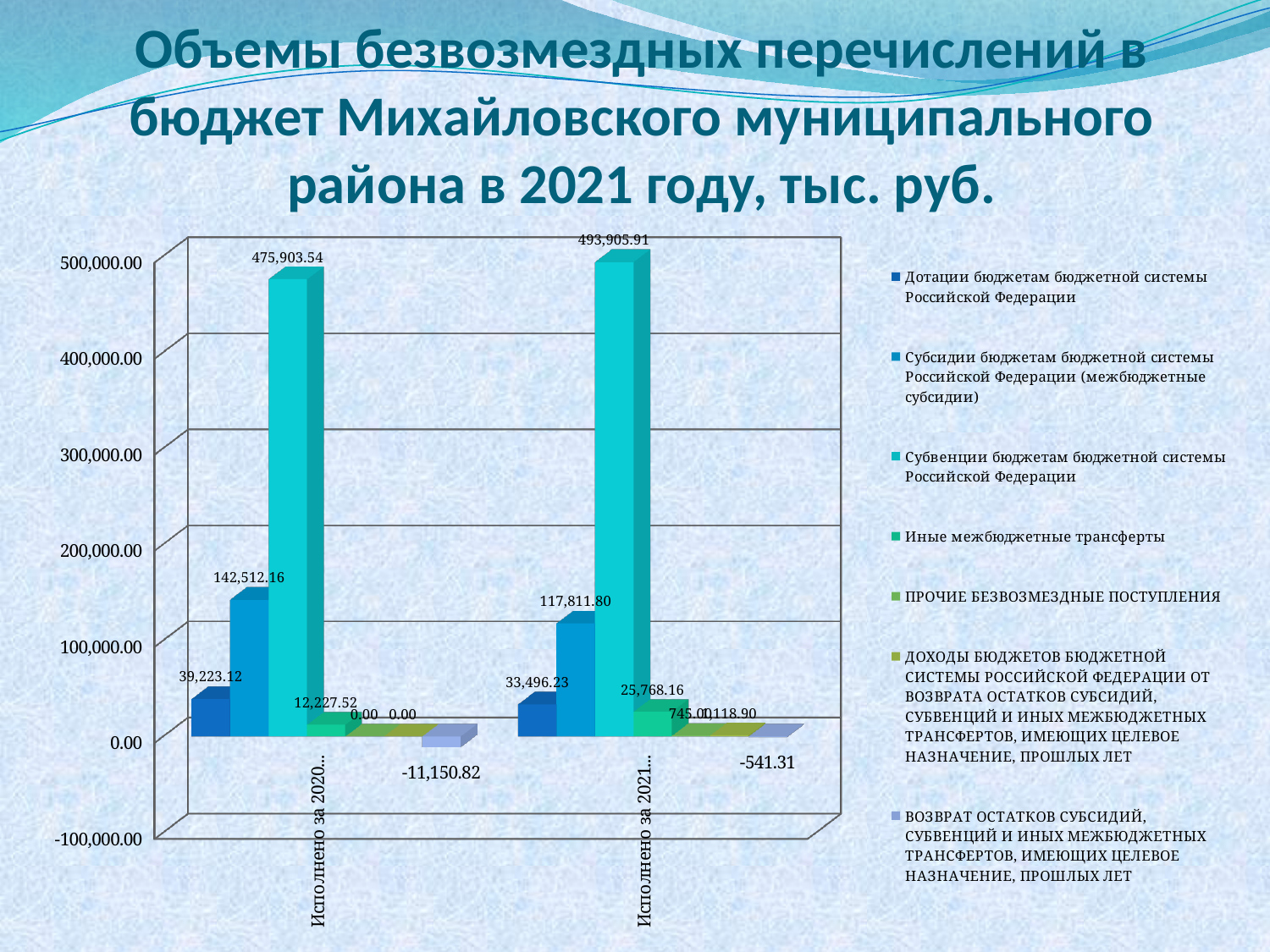
What is the value of Дотации бюджетам бюджетной системы Российской Федерации for the category Исполнено за 2021? 33,496.23 What is the difference between the Субвенции values for Исполнено за 2021 and Исполнено за 2020? 18,002.37 What is the value of Возврат остатков субсидий, субвенций и иных межбюджетных трансфертов, имеющих целевое назначение, прошлых лет for the category Исполнено за 2020? -11,150.82 What is the value of Субвенции бюджетам бюджетной системы Российской Федерации for the category Исполнено за 2021? 493,905.91 What is the value of Иные межбюджетные трансферты for the category Исполнено за 2020? 12,227.52 How many series does the legend list? 7 Which is larger: Субсидии for Исполнено за 2020 or Субсидии for Исполнено за 2021? Исполнено за 2020 Which series has the highest value in the category Исполнено за 2021? Субвенции бюджетам бюджетной системы Российской Федерации Does the value of Дотации бюджетам бюджетной системы Российской Федерации rise or fall from Исполнено за 2020 to Исполнено за 2021? Fall What is the value of Субсидии бюджетам бюджетной системы Российской Федерации (межбюджетные субсидии) for the category Исполнено за 2020? 142,512.16 What kind of chart is shown on the slide? Bar chart Which series has the lowest value in the category Исполнено за 2020? Возврат остатков субсидий, субвенций и иных межбюджетных трансфертов, имеющих целевое назначение, прошлых лет